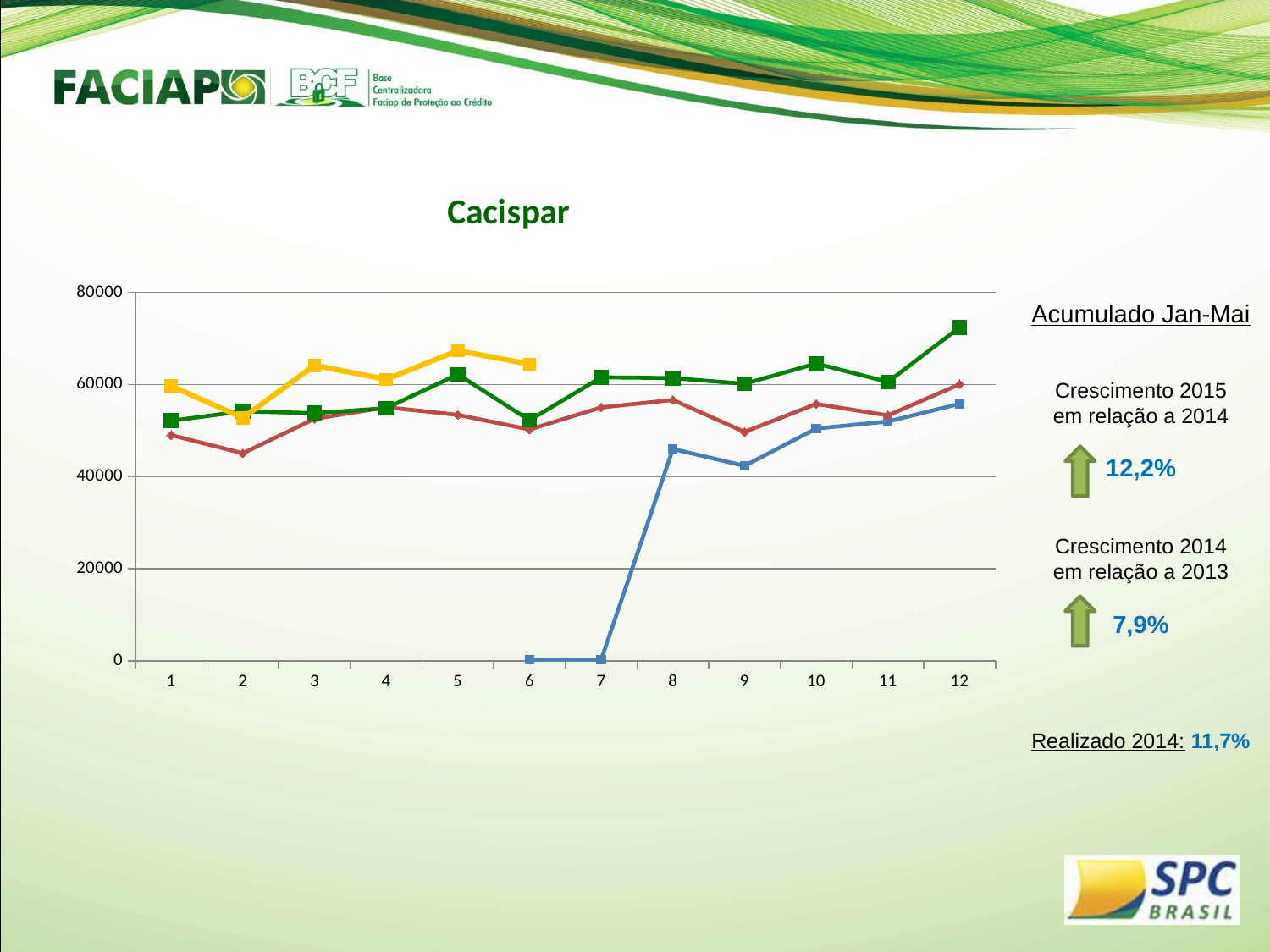
At which x value does the red line reach its lowest point? 2 How many points are labelled along the x axis of the chart? 12 Does the blue line rise or fall from 8 to 12? rise Is the value of the red line at 2 greater or less than 60000? less How many points does the yellow line have? 6 What kind of chart is shown on the slide? line chart Is the value of the blue line at 6 greater or less than 20000? less At x value 1, which line is higher, the yellow line or the red line? yellow What is the title of the chart? Cacispar Is the value of the yellow line at 5 greater or less than 60000? greater At which x value does the green line reach its highest point? 12